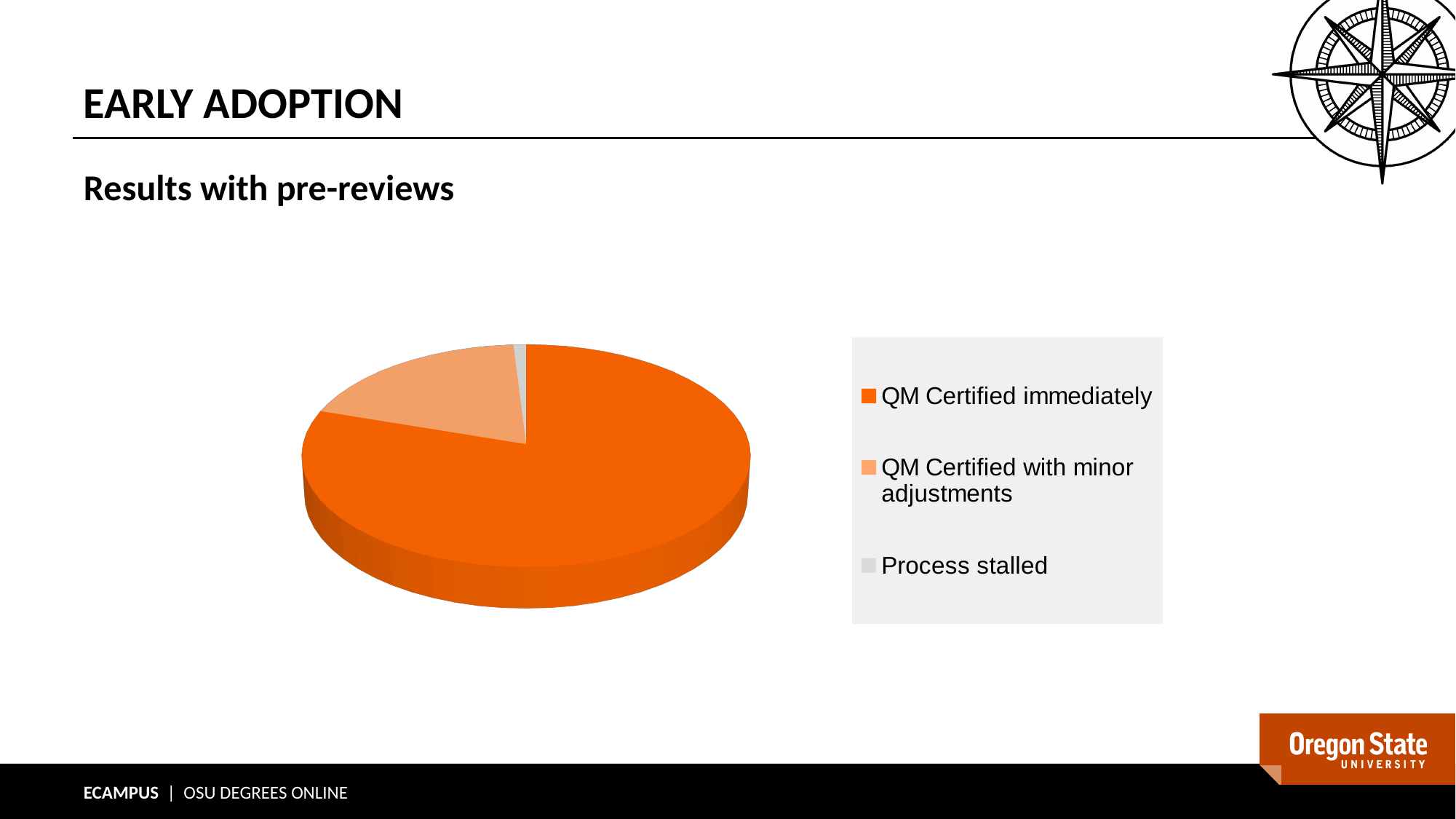
Which legend entry is shown in grey in the pie chart? Process stalled How many entries does the legend of the pie chart list? 3 Which category has the largest slice of the pie chart? QM Certified immediately Which slice is smaller: Process stalled or QM Certified immediately? Process stalled Which category has the smallest slice of the pie chart? Process stalled What kind of chart is shown on the slide? Pie chart How many slices does the pie chart have? 3 Which slice is larger: QM Certified immediately or QM Certified with minor adjustments? QM Certified immediately What colour is the slice for QM Certified immediately in the pie chart? Orange Which slice is larger: QM Certified with minor adjustments or Process stalled? QM Certified with minor adjustments